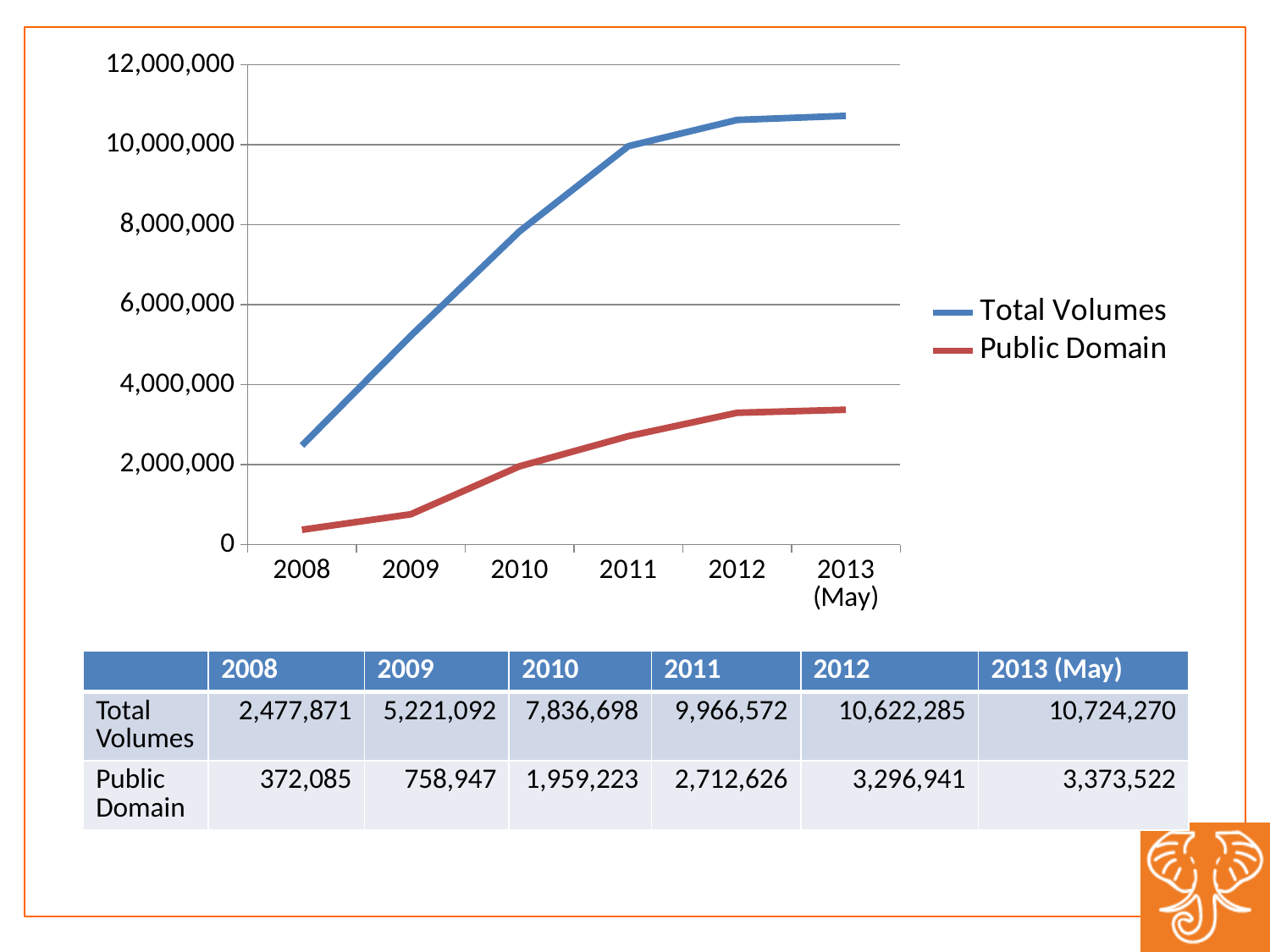
What is the difference between Public Domain in 2012 and in 2011? 584,315 In which year is Public Domain lowest? 2008 By how much did Total Volumes increase from 2008 to 2013 (May)? 8,246,399 What is the value of Total Volumes in 2010? 7,836,698 What is the value of Public Domain in 2008? 372,085 How many years are plotted along the x axis? 6 What type of chart is shown on the slide? line chart What is the value of Public Domain in 2013 (May)? 3,373,522 How many series does the legend list? 2 Which series has the larger value in 2011, Total Volumes or Public Domain? Total Volumes Do the Total Volumes values rise or fall from 2008 to 2013 (May)? rise In which year is Total Volumes highest? 2013 (May)